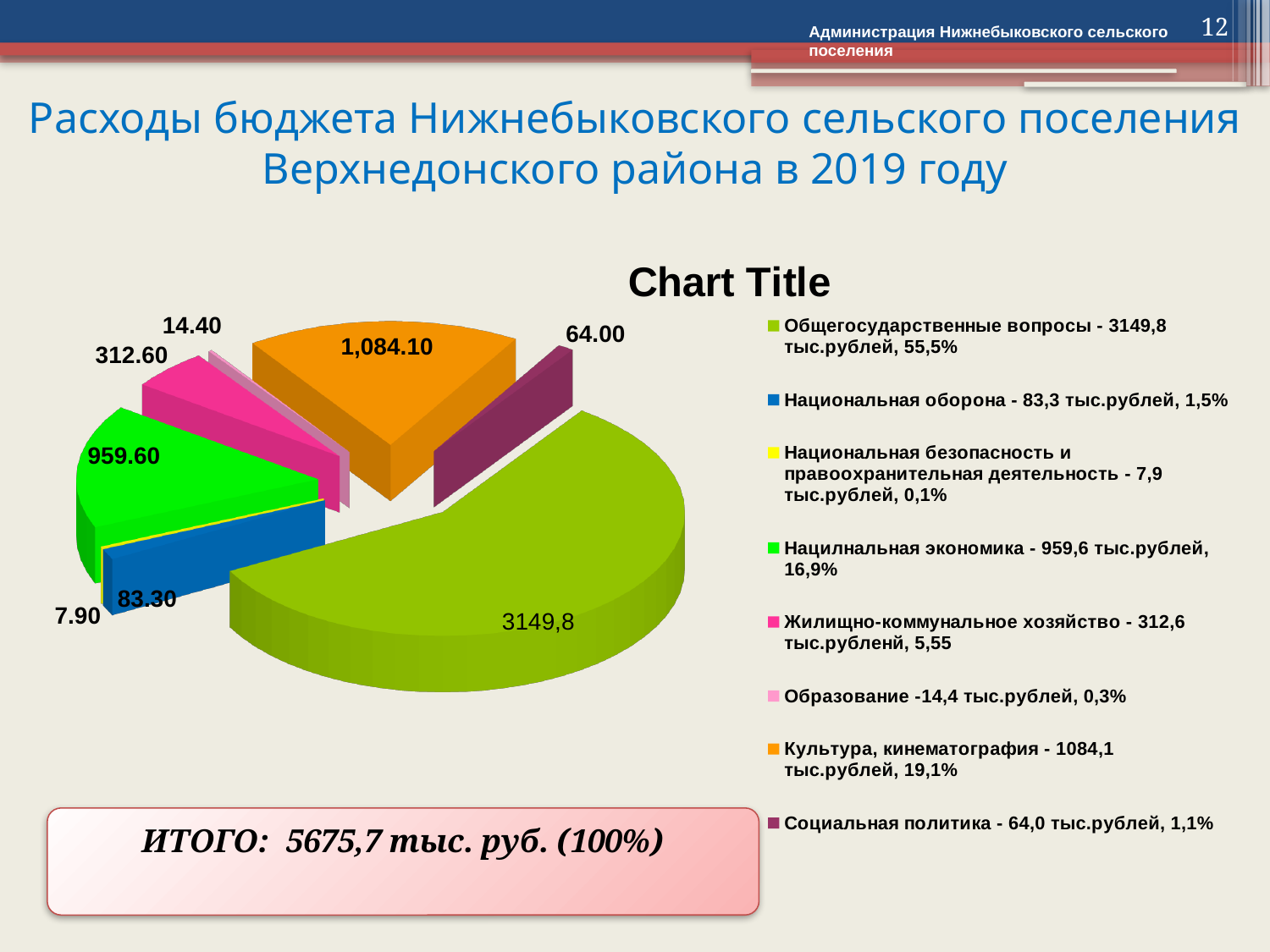
What is the difference between the values for Культура, кинематография (1,084.10) and Нацилнальная экономика (959.60)? 124.50 What value is labelled on the slice for Жилищно-коммунальное хозяйство? 312.60 According to the legend, what share of the pie does Общегосударственные вопросы represent? 55,5% How many slices does the pie chart have? 8 Which category has the largest slice of the pie? Общегосударственные вопросы What value is labelled on the slice for Национальная оборона? 83.30 Which category has the smallest slice of the pie? Национальная безопасность и правоохранительная деятельность How many entries does the chart legend list? 8 What type of chart is shown on the slide? pie chart What is the title shown above the pie chart? Chart Title Which is larger: the value for Жилищно-коммунальное хозяйство or for Национальная оборона? Жилищно-коммунальное хозяйство What value is labelled on the slice for Культура, кинематография? 1,084.10